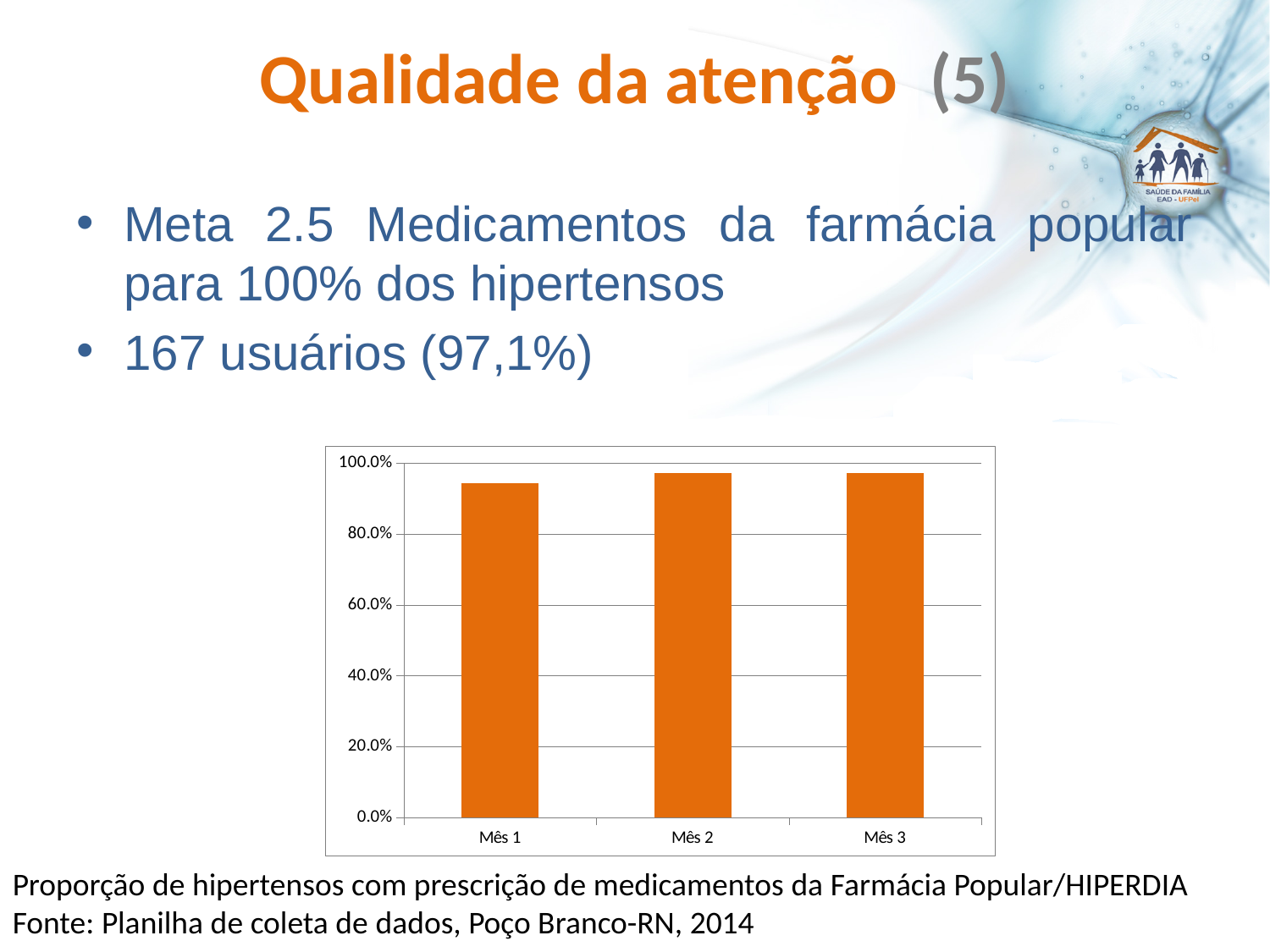
Is the value for Mês 1 greater or less than 80.0%? greater Is the value for Mês 2 greater or less than 100.0%? less Do the values rise or fall from Mês 1 to Mês 2? rise What colour are the bars in the chart? orange Which is larger, the value for Mês 1 or the value for Mês 2? Mês 2 How many categories (months) are plotted on the chart? 3 What is the label of the first category on the x axis? Mês 1 Is the value for Mês 3 greater or less than 60.0%? greater What is the highest value shown on the vertical axis of the chart? 100.0% What kind of chart is shown on the slide? bar chart Which month has the lowest bar on the chart? Mês 1 What is the label of the last category on the x axis? Mês 3